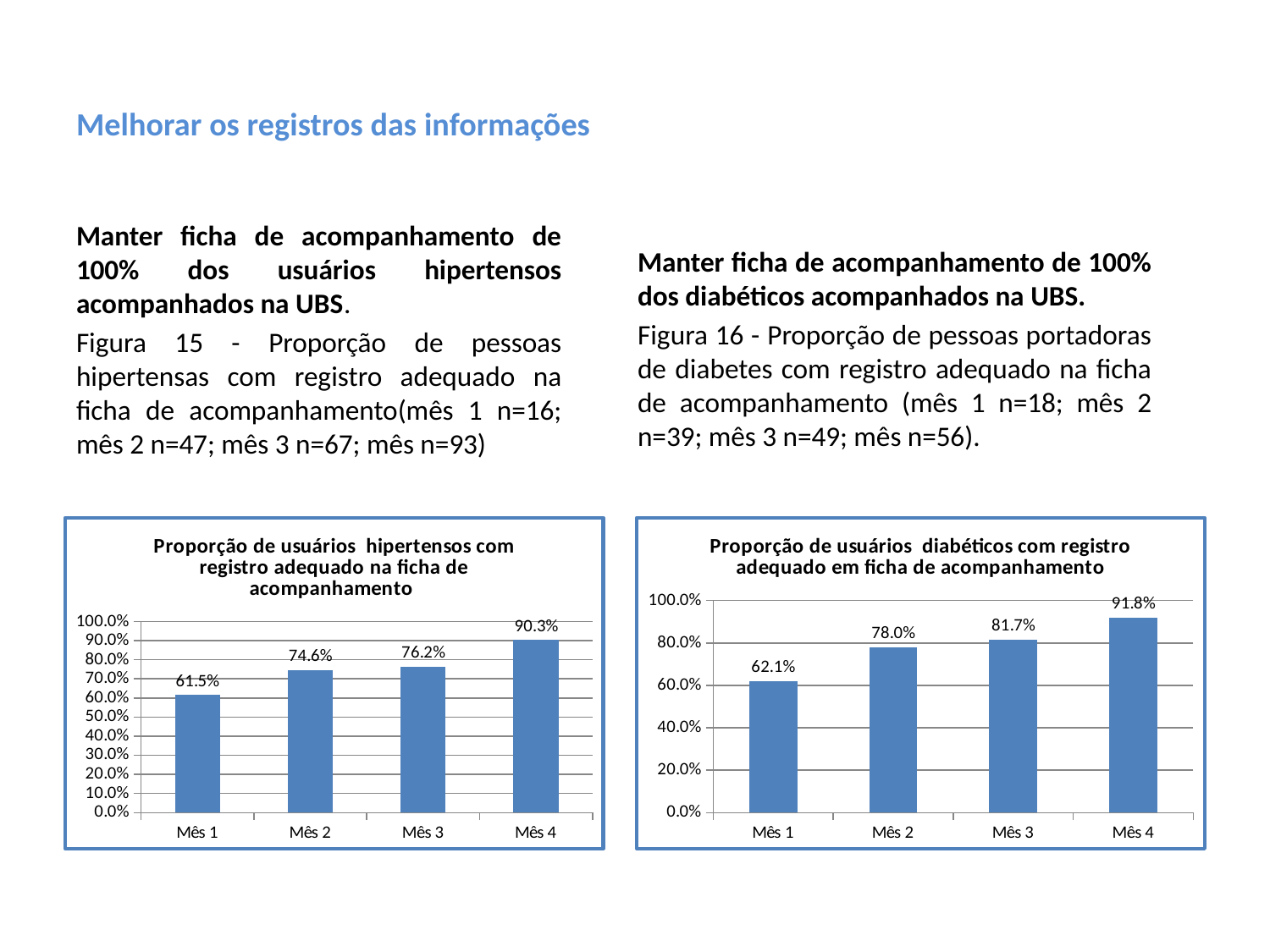
In the left chart (hipertensos), which month has the highest value? Mês 4 What kind of chart is the right chart (diabéticos)? Bar chart In the right chart (diabéticos), which is larger, the value for Mês 1 or the value for Mês 3? Mês 3 In the right chart (diabéticos), what is the value for Mês 2? 78.0% In the left chart (hipertensos), what is the value for Mês 4? 90.3% In the right chart (diabéticos), what is the difference between the values for Mês 3 and Mês 2? 3.7% In the left chart (hipertensos), do the values rise or fall from Mês 1 to Mês 4? Rise In the left chart (hipertensos), what is the difference between the values for Mês 4 and Mês 1? 28.8% In the left chart (hipertensos), how many months are plotted? 4 In the right chart (diabéticos), which month has the lowest value? Mês 1 In the right chart (diabéticos), what is the value for Mês 4? 91.8% In the left chart (hipertensos), what is the value for Mês 1? 61.5%